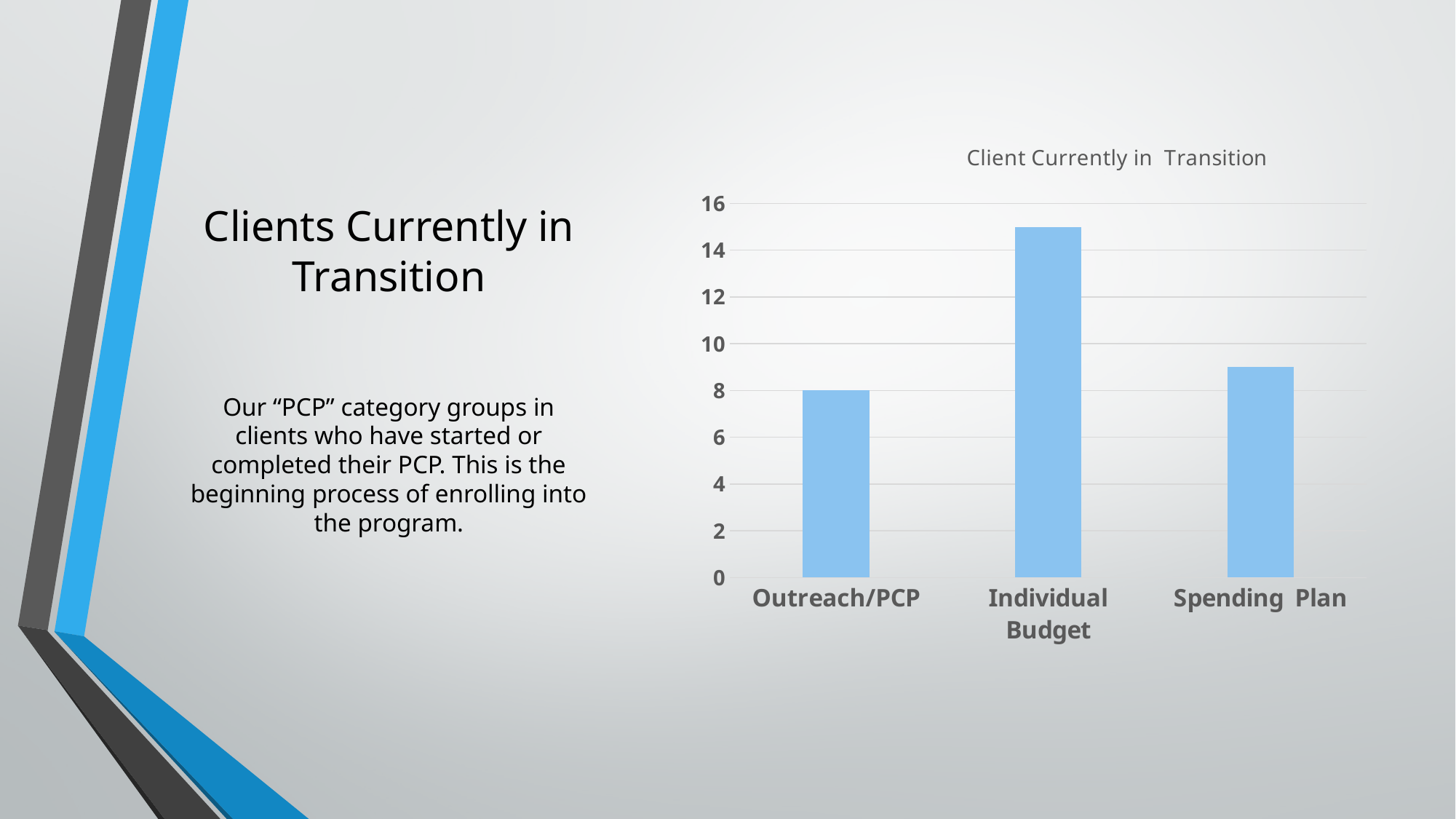
Which is larger, the value for Individual Budget or the value for Spending Plan? Individual Budget Which is larger, the value for Spending Plan or the value for Outreach/PCP? Spending Plan Is the value for Individual Budget greater or less than 14? greater Which category has the lowest bar in the chart? Outreach/PCP How many categories are shown on the x axis of the chart? 3 Is the value for Outreach/PCP greater or less than 10? less Is the value for Spending Plan greater or less than 10? less Which category has the highest bar in the chart? Individual Budget What kind of chart is shown on the slide? bar chart What is the value for Outreach/PCP in the chart? 8 What is the title of the chart? Client Currently in Transition